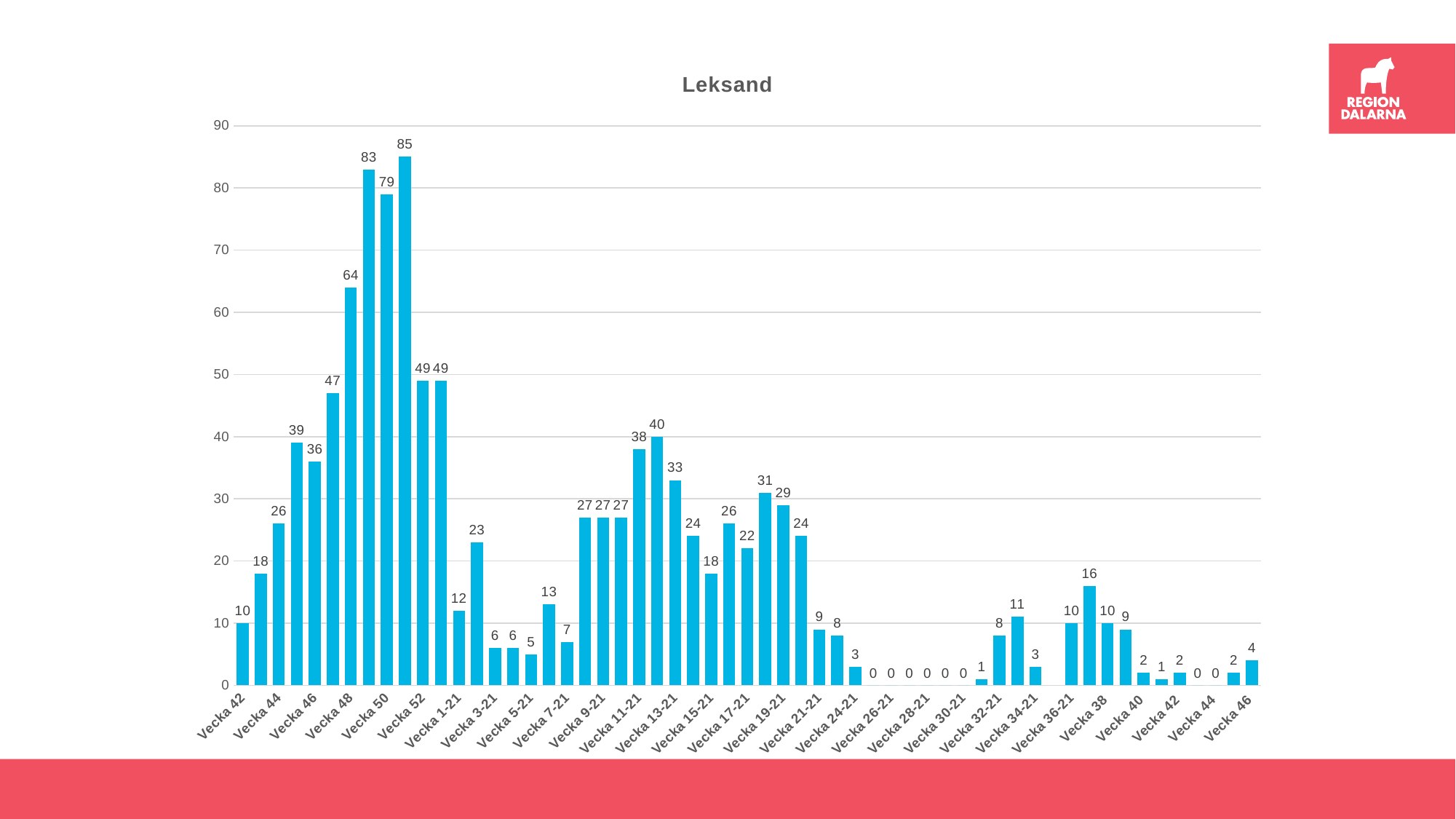
What is the value for Vecka 11-21? 38 What kind of chart is shown on the slide? bar chart What is the title of the chart? Leksand Is the value for Vecka 13-21 greater or less than 30? greater Which is larger, the value for Vecka 48 or the value for Vecka 52? Vecka 48 What is the value for Vecka 50? 79 What is the highest value shown on the chart? 85 What is the value for Vecka 48? 64 Do the values rise or fall from the first Vecka 42 to Vecka 50? rise What is the difference between the values for Vecka 50 and Vecka 48? 15 What is the value for Vecka 1-21? 12 What is the value for Vecka 19-21? 29